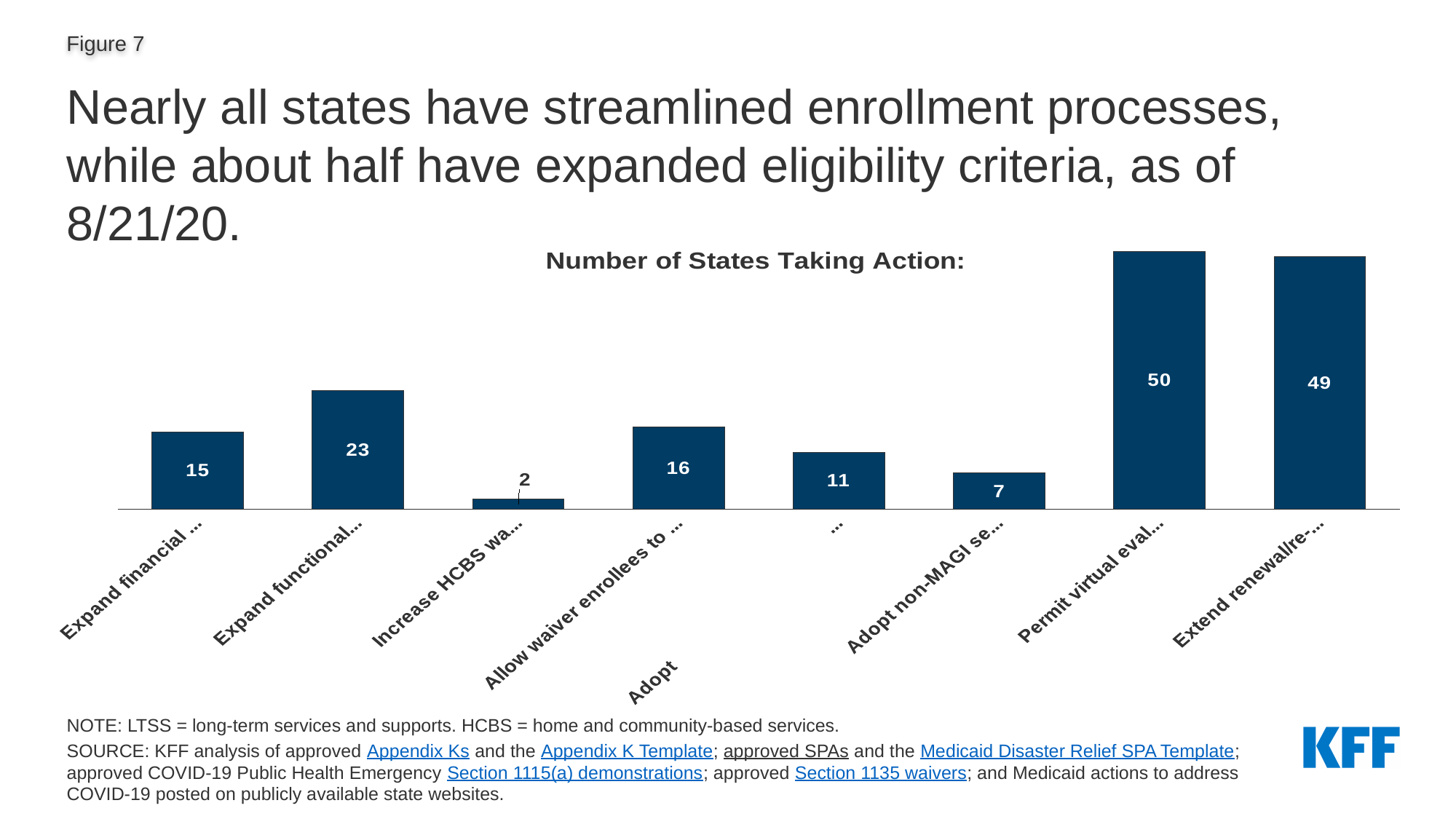
What is the value of the bar labeled "Expand financial ..."? 15 How many bars (categories) does the chart show? 8 Which category has the highest number of states taking action? Permit virtual eval... What is the value of the bar labeled "Permit virtual eval..."? 50 What is the difference between the values for "Permit virtual eval..." and "Extend renewal/re-..."? 1 What is the value of the bar labeled "Increase HCBS wa..."? 2 Which category has the lowest number of states taking action? Increase HCBS wa... What is the value of the bar labeled "Expand functional..."? 23 What is the title of the chart? Number of States Taking Action: What is the value of the bar labeled "Adopt non-MAGI se..."? 7 Which is larger: the value for "Expand functional..." or the value for "Allow waiver enrollees to ..."? Expand functional... What type of chart is shown on the slide? bar chart